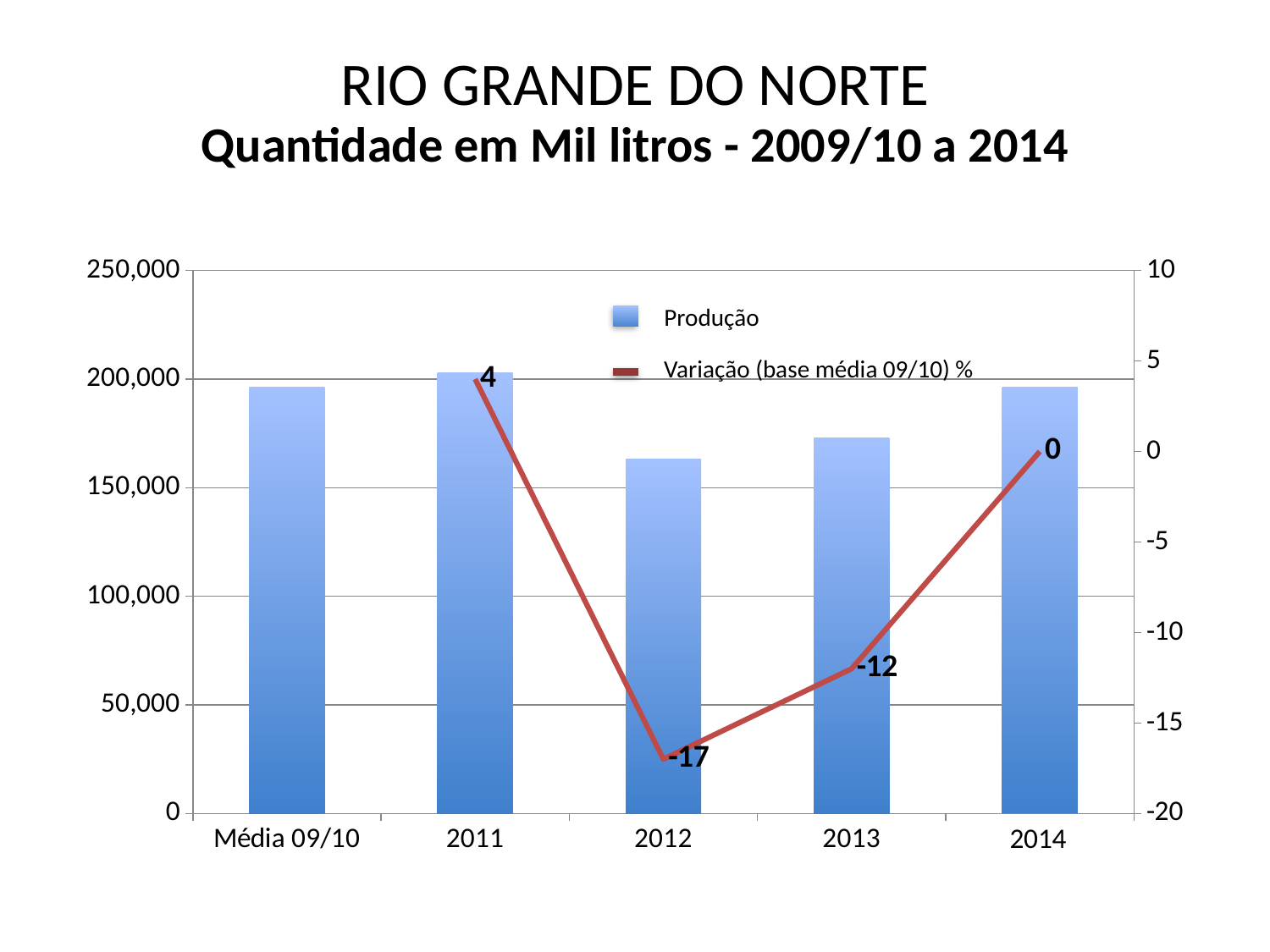
Is the Produção value for 2012 greater or less than 200,000? less Which year has the highest Variação (base média 09/10) % value? 2011 Is the Produção bar for 2013 larger or smaller than the bar for 2012? larger What is the Variação (base média 09/10) % value for 2011? 4 What is the Variação (base média 09/10) % value for 2012? -17 What is the Variação (base média 09/10) % value for 2014? 0 How many categories are shown on the x axis? 5 Which category has the lowest Produção bar? 2012 Is the Produção value for 2011 greater or less than 200,000? greater What is the difference between the Variação values for 2011 and 2012? 21 How many series does the legend list? 2 Which year has the lowest Variação (base média 09/10) % value? 2012